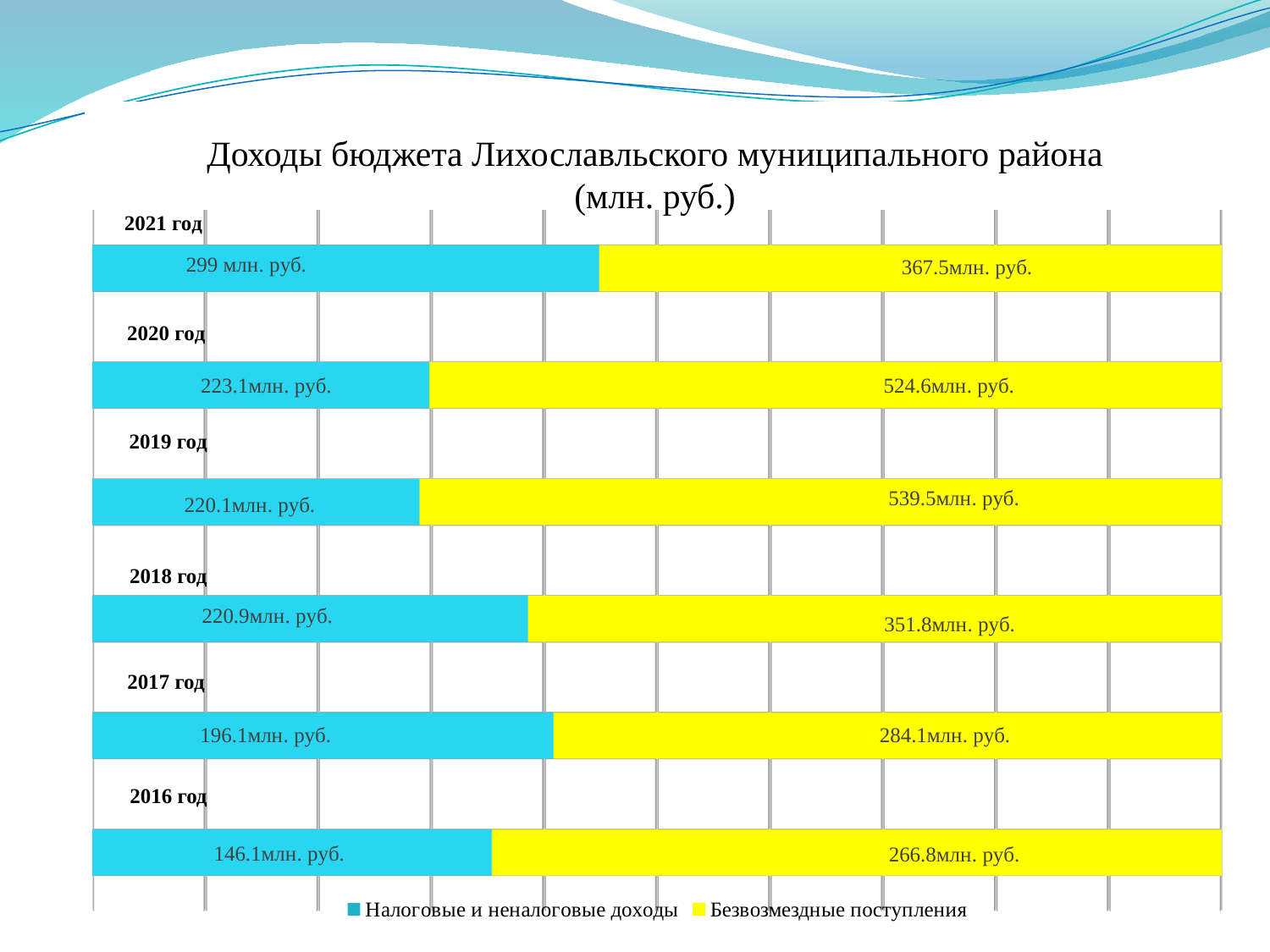
What is the value of Безвозмездные поступления for 2019 год? 539.5млн. руб. How many years are shown on the chart? 6 Which is larger in 2017 год: Налоговые и неналоговые доходы or Безвозмездные поступления? Безвозмездные поступления What is the total of the two series for 2018 год? 572.7 млн. руб. What is the difference between Безвозмездные поступления and Налоговые и неналоговые доходы in 2020 год? 301.5 млн. руб. What is the value of Налоговые и неналоговые доходы for 2021 год? 299 млн. руб. What kind of chart is shown on the slide? Stacked bar chart Which colour represents Безвозмездные поступления in the chart? Yellow Which year has the highest value of Безвозмездные поступления? 2019 год How many series does the legend list? 2 What is the value of Налоговые и неналоговые доходы for 2016 год? 146.1млн. руб. Which year has the lowest value of Налоговые и неналоговые доходы? 2016 год